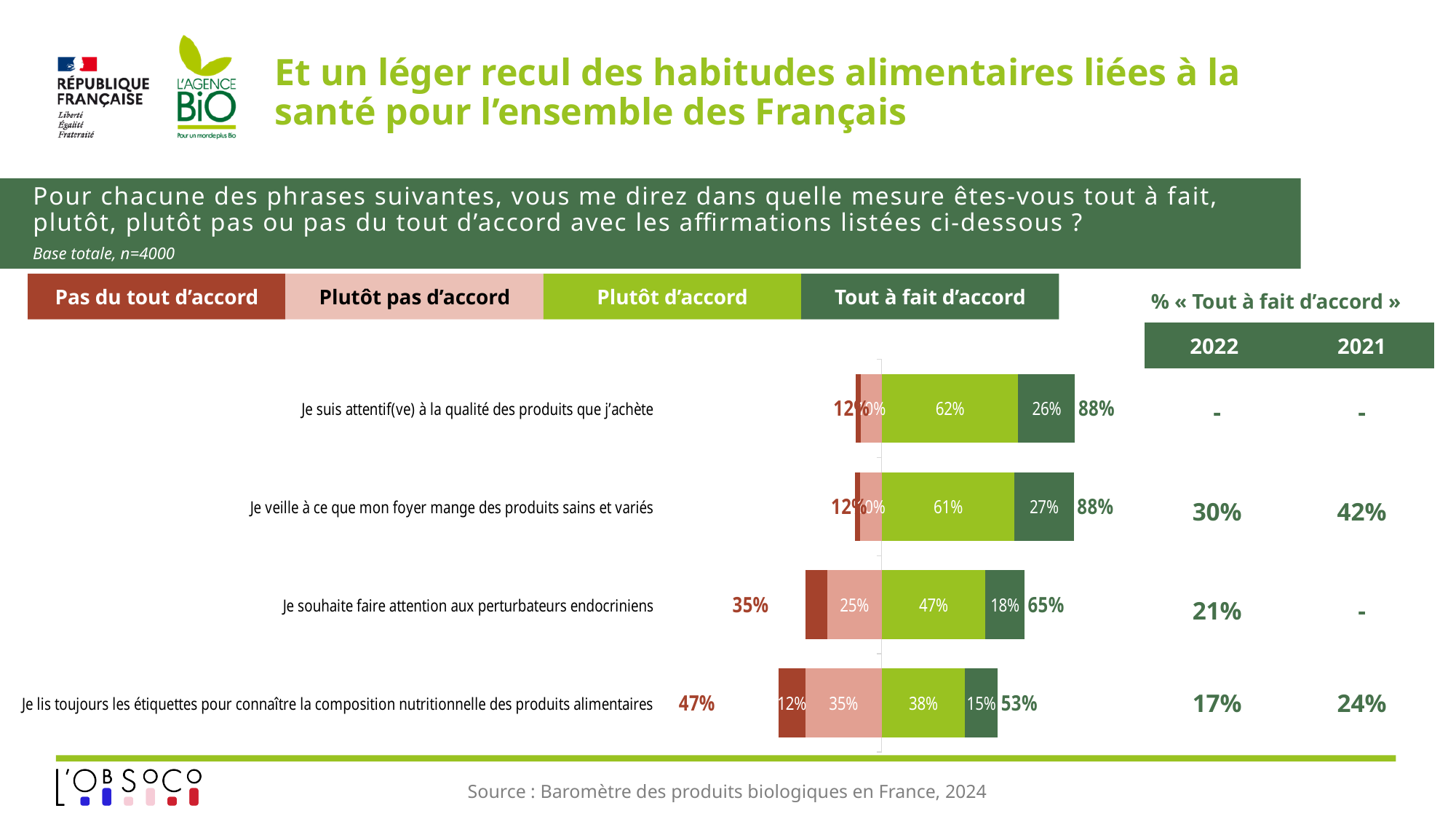
What is the difference between the 'Plutôt d'accord' share (47%) and the 'Tout à fait d'accord' share (18%) for 'Je souhaite faire attention aux perturbateurs endocriniens'? 29 percentage points Which is larger for 'Je lis toujours les étiquettes...': the 'Plutôt pas d'accord' share or the 'Plutôt d'accord' share? Plutôt d'accord (38%) In the '% Tout à fait d'accord' table, what was the 2021 value for 'Je veille à ce que mon foyer mange des produits sains et variés'? 42% What percentage answered 'Tout à fait d'accord' to 'Je veille à ce que mon foyer mange des produits sains et variés'? 27% Which statement has the lowest total agreement percentage shown to the right of its bar? Je lis toujours les étiquettes pour connaître la composition nutritionnelle des produits alimentaires What is the 'Pas du tout d'accord' share for 'Je lis toujours les étiquettes pour connaître la composition nutritionnelle des produits alimentaires'? 12% What type of chart is shown on the slide? Stacked bar chart How many statements are plotted in the chart? 4 What is the 'Plutôt pas d'accord' share for 'Je souhaite faire attention aux perturbateurs endocriniens'? 25% What percentage of respondents answered 'Plutôt d'accord' to 'Je suis attentif(ve) à la qualité des produits que j'achète'? 62% How many response categories does the legend list? 4 In the '% Tout à fait d'accord' table, by how many percentage points did the value for 'Je lis toujours les étiquettes...' fall from 2021 (24%) to 2022 (17%)? 7 percentage points